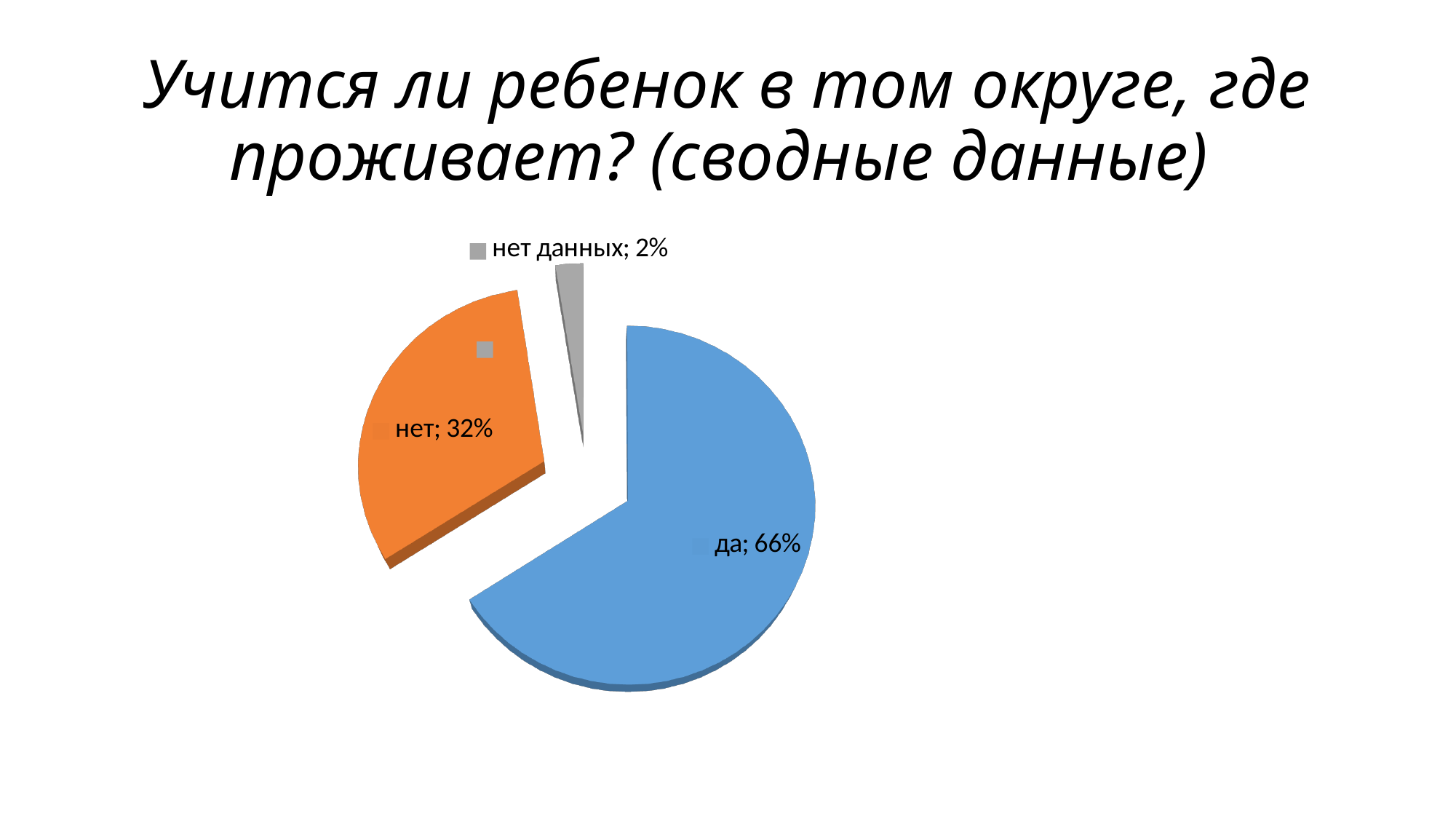
Which is larger, the "нет" slice or the "нет данных" slice? нет What colour is the "нет" slice? orange What share of the pie does the "да" slice represent? 66% Which category has the smallest slice of the pie? нет данных What share of the pie does the "нет данных" slice represent? 2% How many slices does the pie chart have? 3 What share of the pie does the "нет" slice represent? 32% Which category has the largest slice of the pie? да What kind of chart is shown on the slide? pie chart What is the difference in percentage points between the "да" and "нет" slices? 34 What colour is the "да" slice? blue